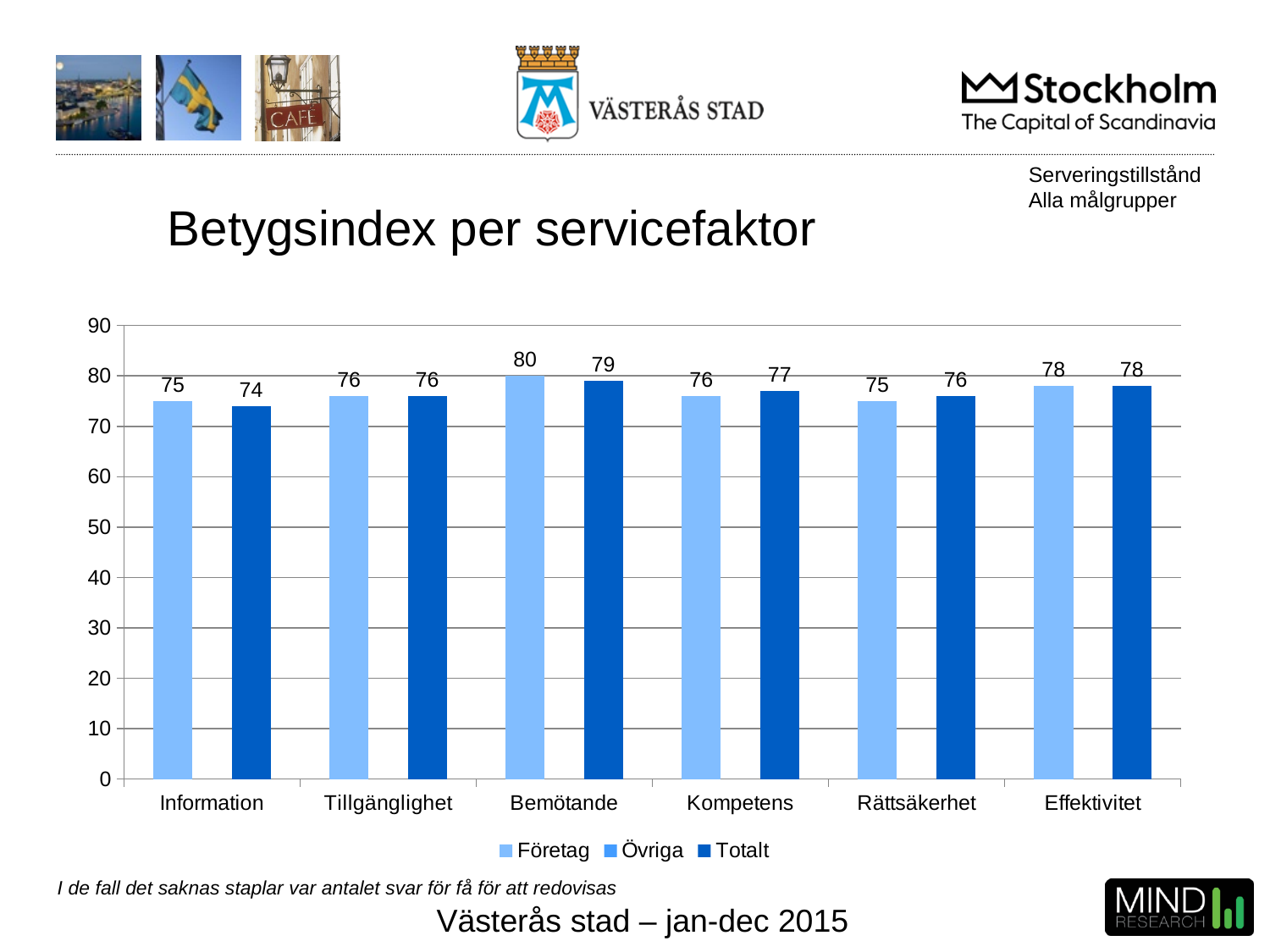
What is the difference between the Totalt values for Bemötande and Information? 5 What is the Företag value for Effektivitet? 78 What is the difference between the Företag and Totalt values for Bemötande? 1 Which service factor has the lowest Totalt value? Information What is the Företag value for Bemötande? 80 What is the Totalt value for Kompetens? 77 What kind of chart is shown on the slide? Bar chart Which service factor has the highest Företag value? Bemötande What is the Totalt value for Information? 74 How many series does the legend list? 3 Which is larger for Kompetens, the Företag value or the Totalt value? Totalt How many service factors are shown on the x axis? 6